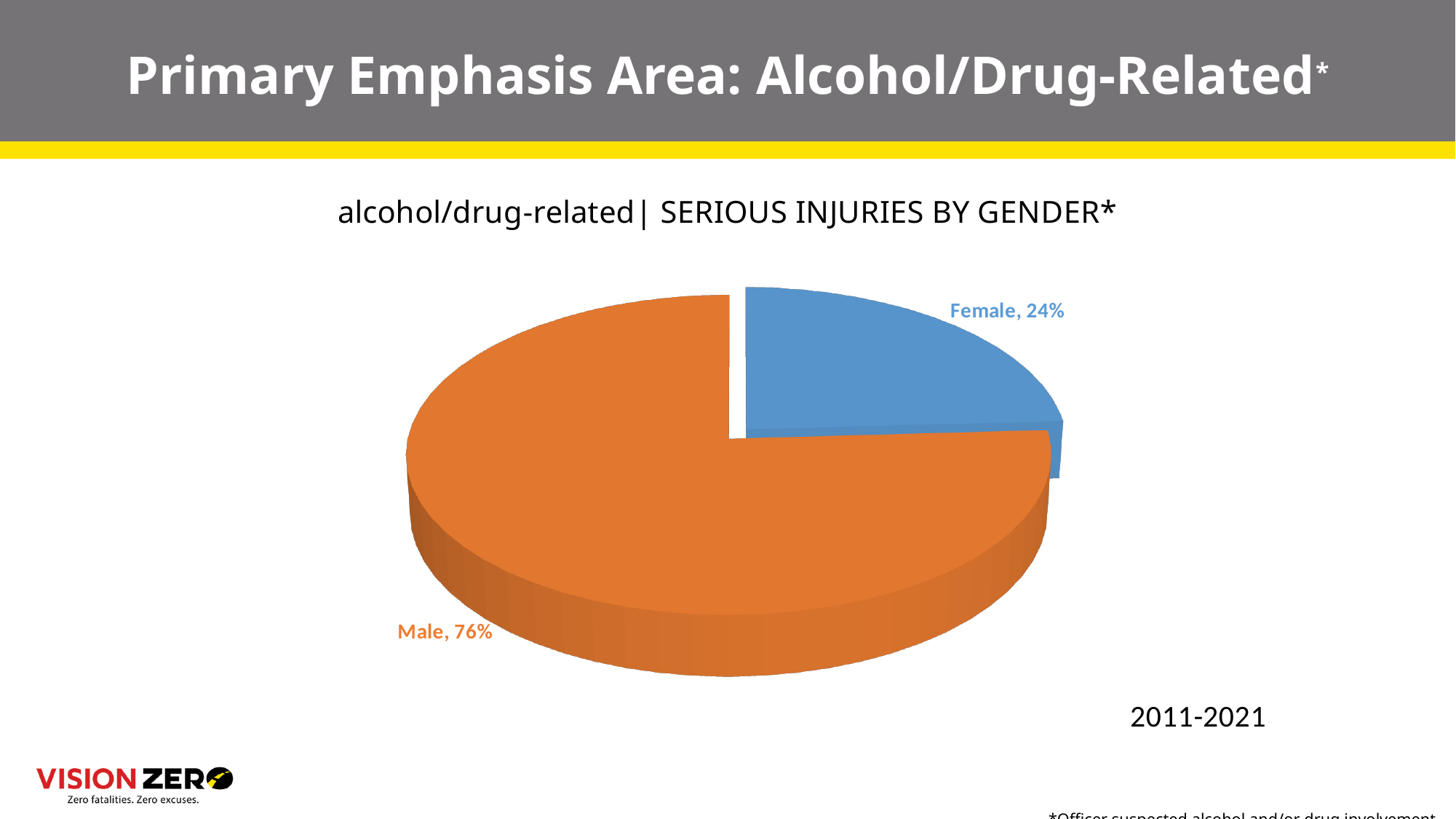
What time period does the chart cover, as shown on the slide? 2011-2021 What is the difference in percentage points between the Male and Female slices? 52 percentage points Which slice is larger, Male or Female? Male Which gender has the largest slice of the pie? Male What share of alcohol/drug-related serious injuries is attributed to males? 76% Which gender has the smallest slice of the pie? Female What kind of chart is shown on the slide? Pie chart Is the Female share greater or less than 50%? less How many slices does the pie chart have? 2 What is the title of the chart? alcohol/drug-related | SERIOUS INJURIES BY GENDER* What colour is the Male slice of the pie? Orange What share of alcohol/drug-related serious injuries is attributed to females? 24%